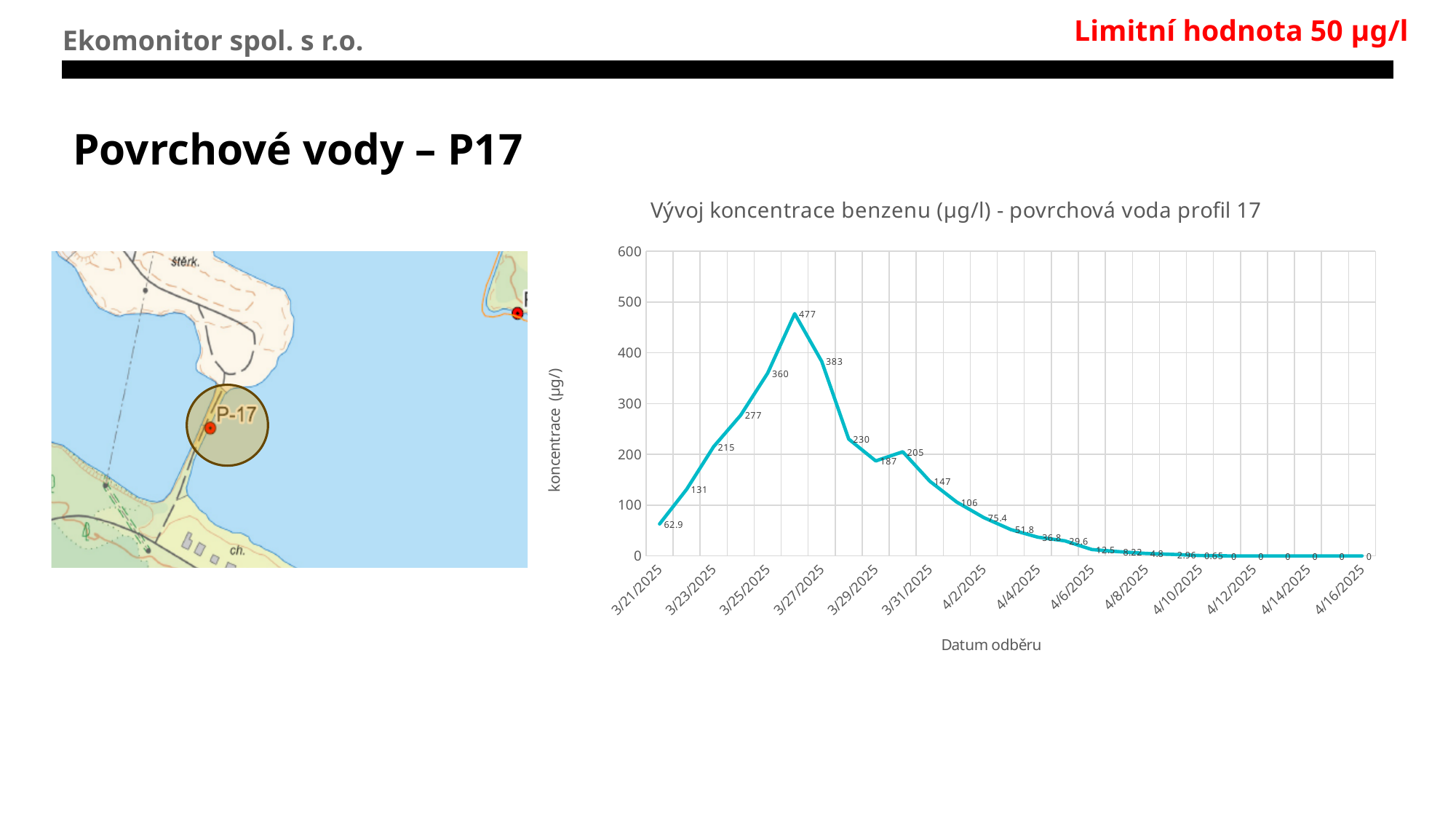
What is the benzene concentration on 3/21/2025? 62.9 What type of chart is shown on the slide? line chart What is the difference between the peak value of 477 and the following value of 383? 94 What is the benzene concentration on 4/10/2025? 0.65 After the peak, do the benzene concentration values rise or fall toward 4/16/2025? fall What is the highest benzene concentration value plotted on the chart? 477 What is the benzene concentration on 3/27/2025? 383 Is the benzene concentration on 3/25/2025 greater or less than 300? greater What is the benzene concentration on 3/23/2025? 215 What is the title of the chart? Vývoj koncentrace benzenu (µg/l) - povrchová voda profil 17 What is the benzene concentration on 4/2/2025? 75.4 Which date has the higher benzene concentration, 3/23/2025 or 3/29/2025? 3/23/2025